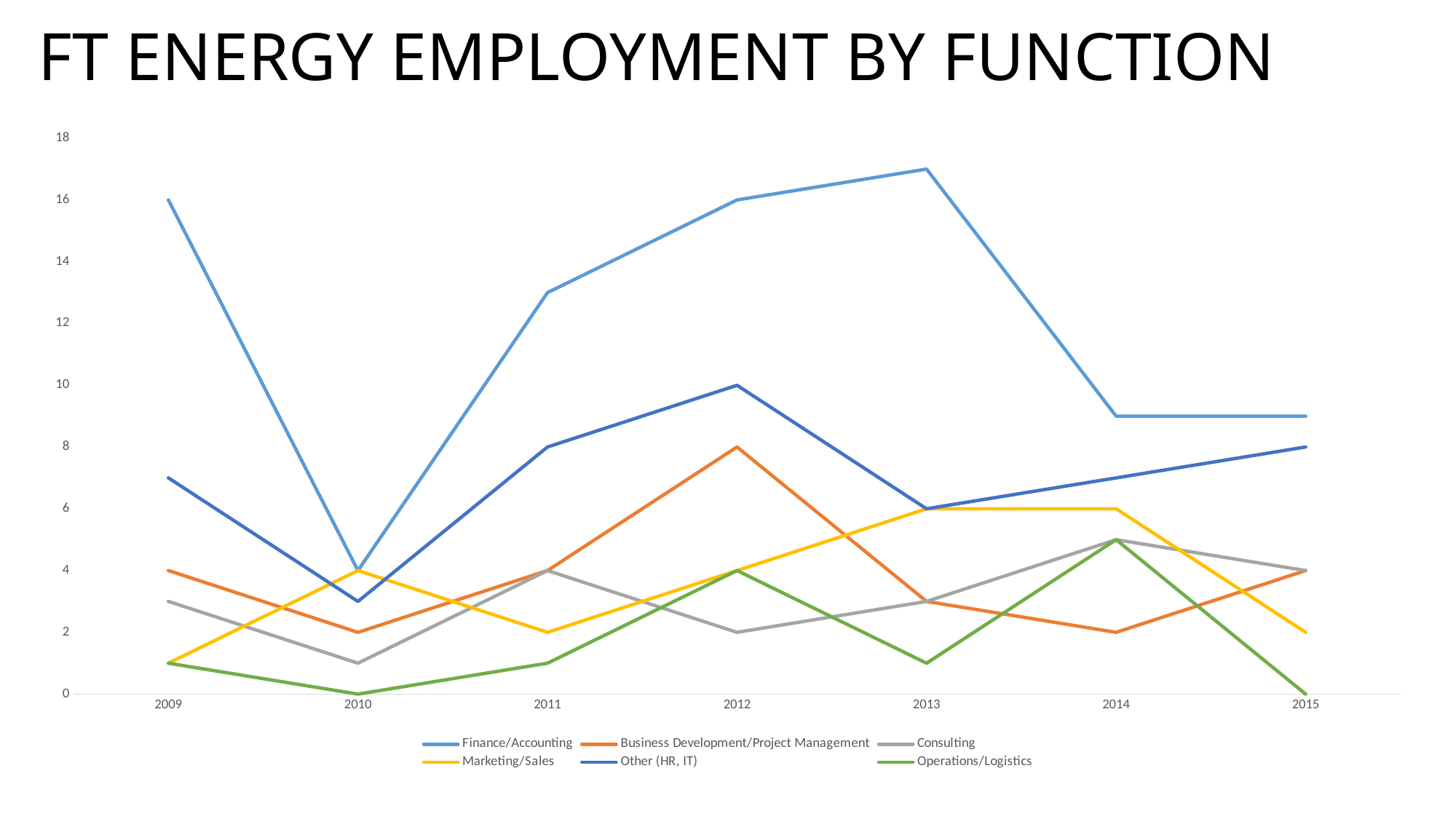
In 2012, which is larger: Finance/Accounting or Other (HR, IT)? Finance/Accounting What is the value for Operations/Logistics in 2015? 0 In which year is Finance/Accounting at its highest? 2013 What is the difference between the Finance/Accounting values in 2009 and 2010? 12 What is the value for Finance/Accounting in 2009? 16 What is the value for Business Development/Project Management in 2012? 8 Is the value for Finance/Accounting in 2014 greater or less than 10? less How many series does the legend list? 6 What kind of chart is shown on the slide? line chart Does the Finance/Accounting line rise or fall from 2013 to 2014? fall How many years are shown on the x axis? 7 What is the value for Other (HR, IT) in 2012? 10